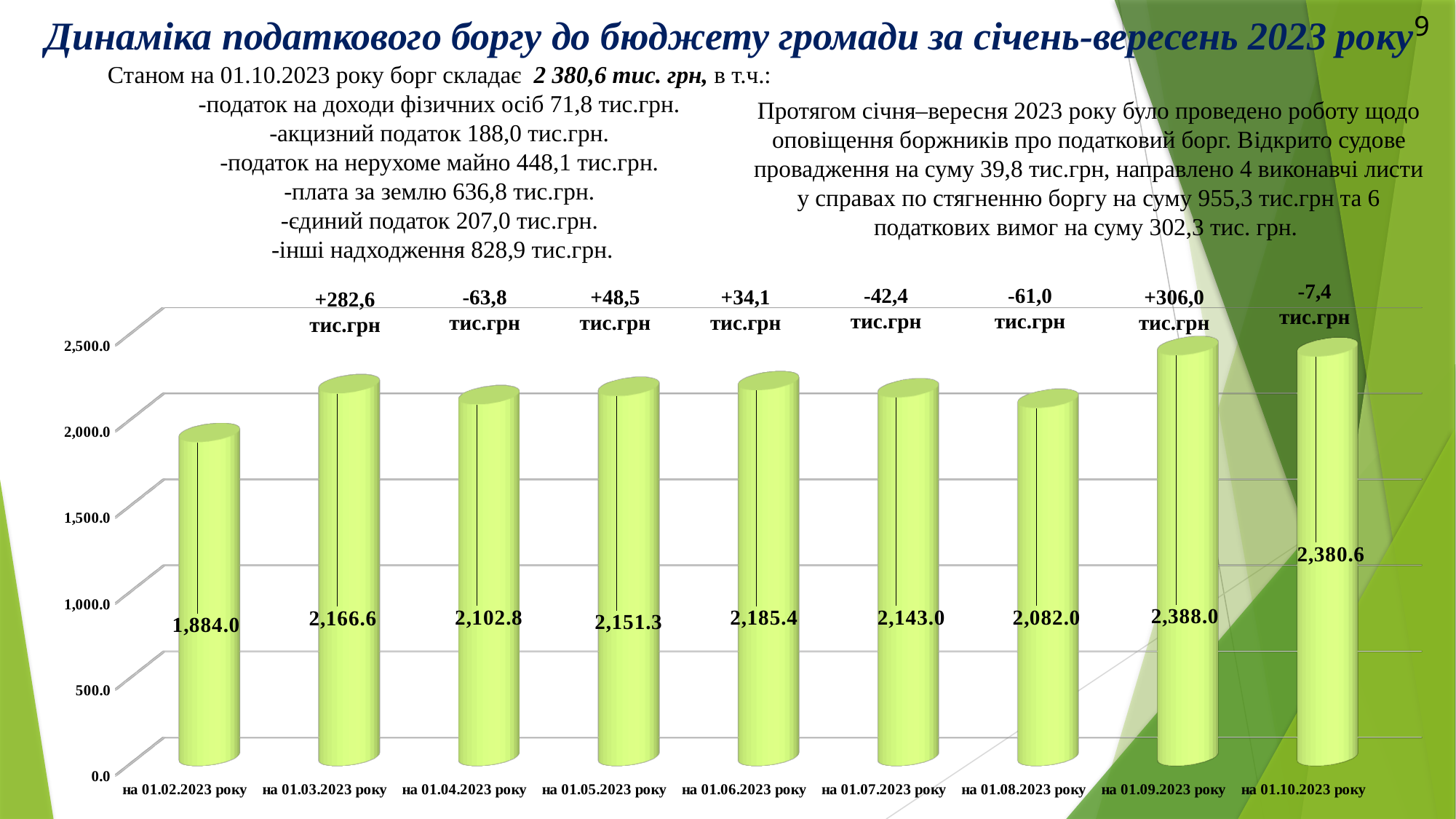
Is the value for на 01.02.2023 року greater or less than 2,000.0? less What kind of chart is shown on the slide? bar chart How many dates (bars) are shown on the chart? 9 What is the value shown for на 01.10.2023 року? 2,380.6 Which is larger, the value for на 01.08.2023 року or the value for на 01.07.2023 року? на 01.07.2023 року What is the tax debt value shown for на 01.02.2023 року? 1,884.0 What change in тис.грн is printed above the bar for на 01.04.2023 року? -63,8 тис.грн What is the value shown for на 01.06.2023 року? 2,185.4 What is the value shown for на 01.09.2023 року? 2,388.0 What is the difference between the values for на 01.03.2023 року and на 01.02.2023 року? 282.6 Which date has the lowest tax debt value on the chart? на 01.02.2023 року Which date has the highest tax debt value on the chart? на 01.09.2023 року